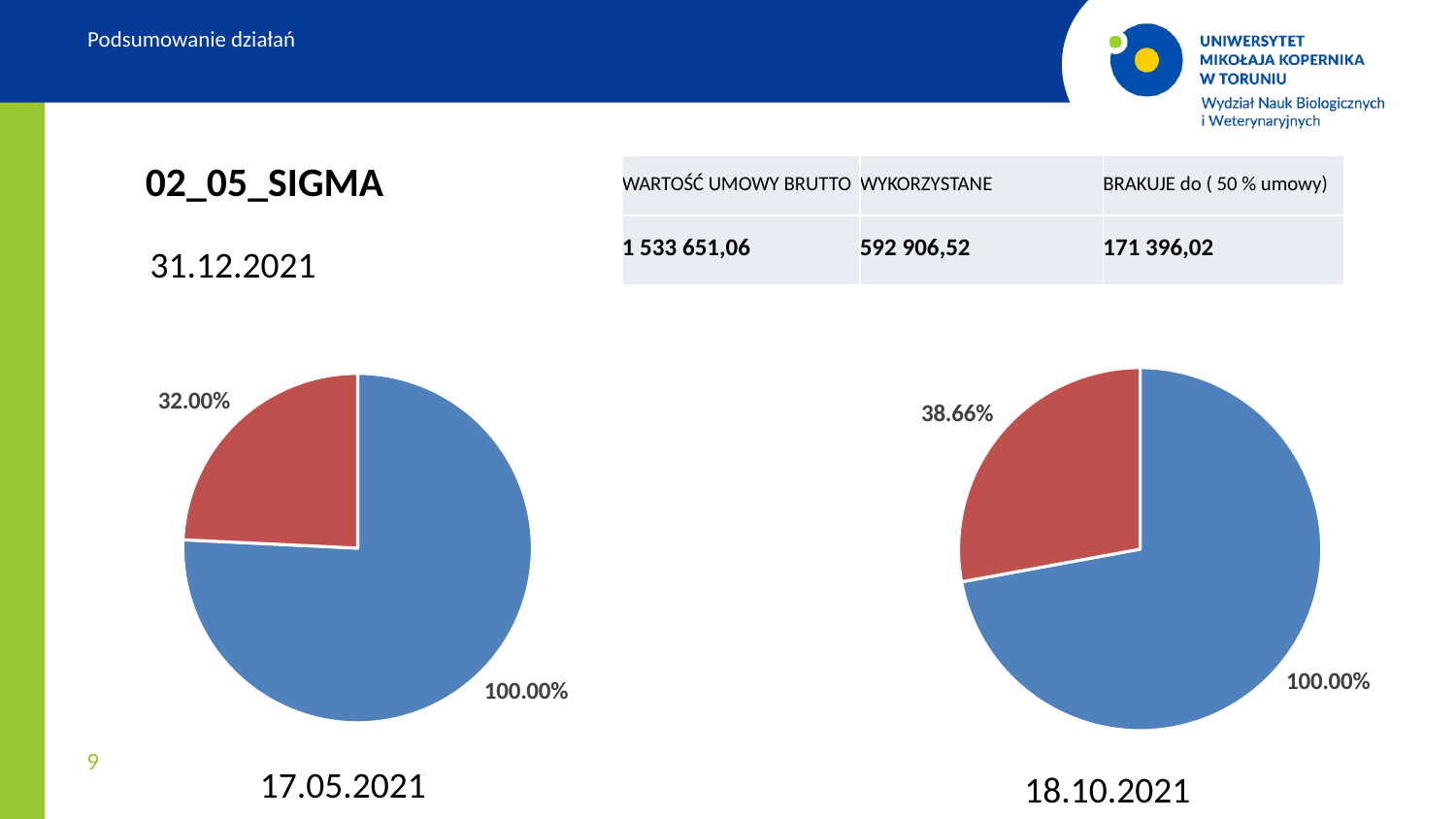
What two colours are used for the slices in both pie charts? Blue and red In the left pie chart (17.05.2021), what label is printed next to the blue slice? 100.00% How many slices does the right pie chart (18.10.2021) have? 2 In the left pie chart (17.05.2021), which slice is larger, the red one or the blue one? Blue What kind of chart is shown on the right side of the slide, above the date 18.10.2021? Pie chart In the left pie chart (17.05.2021), what percentage is printed next to the red slice? 32.00% In the right pie chart (18.10.2021), what percentage is printed next to the red slice? 38.66% What kind of chart is shown on the left side of the slide, above the date 17.05.2021? Pie chart In the right pie chart (18.10.2021), what label is printed next to the blue slice? 100.00% What is the difference in percentage points between the red slice labels of the right pie chart (38.66%) and the left pie chart (32.00%)? 6.66% Which pie chart has the larger red slice, the one dated 17.05.2021 or the one dated 18.10.2021? 18.10.2021 How many slices does the left pie chart (17.05.2021) have? 2